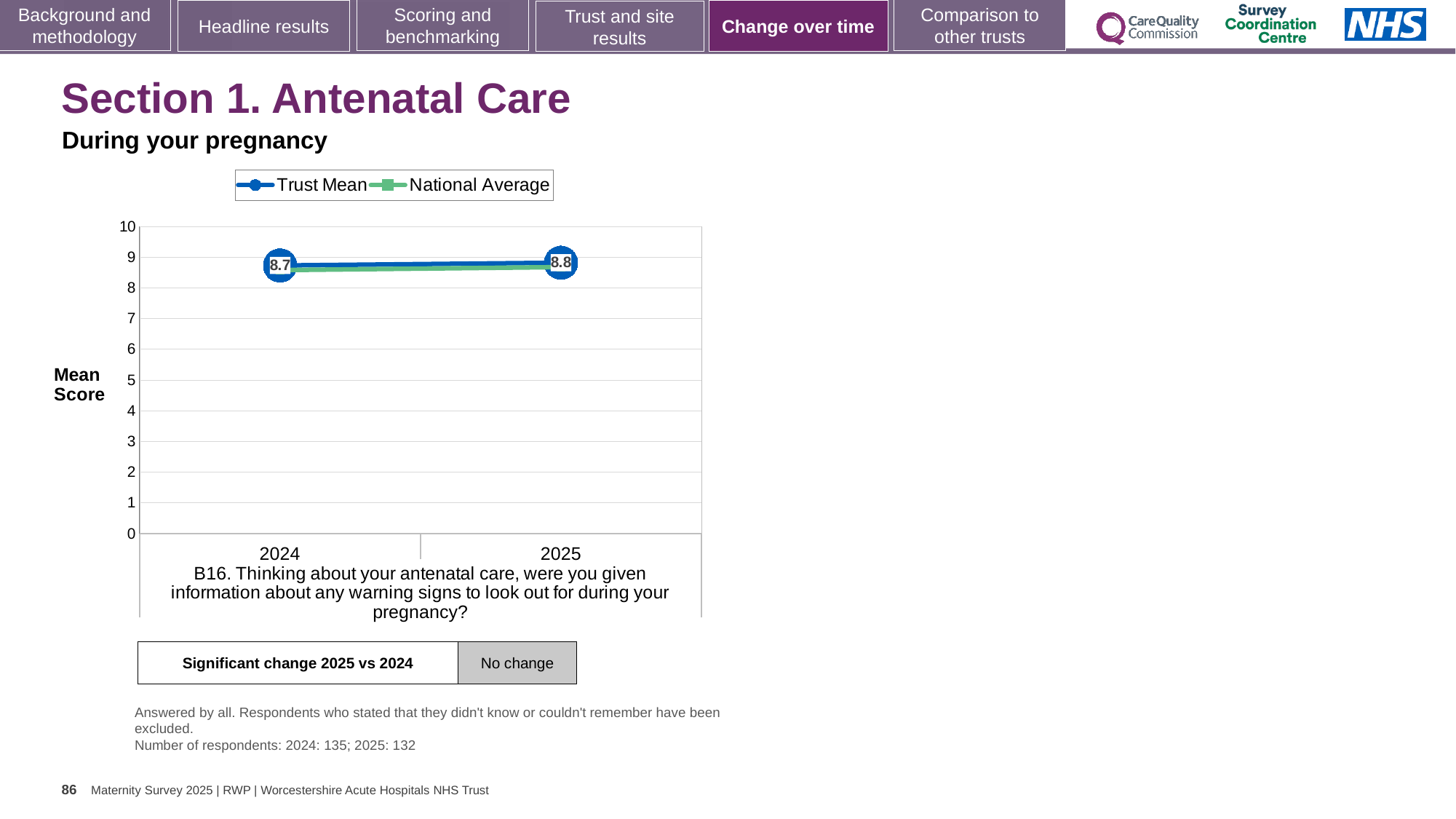
How many years are plotted on the x axis? 2 What is the difference between the Trust Mean in 2025 and in 2024? 0.1 Is the National Average value for 2024 greater or less than 8? greater Is the Trust Mean value for 2025 greater or less than 9? less Which year has the higher Trust Mean, 2024 or 2025? 2025 What is the Trust Mean value for 2025? 8.8 What are the two series named in the chart legend? Trust Mean and National Average Does the Trust Mean rise or fall from 2024 to 2025? rise What kind of chart is shown on the slide? line chart What is the Trust Mean value for 2024? 8.7 How many series does the legend list? 2 What is the label on the y axis of the chart? Mean Score